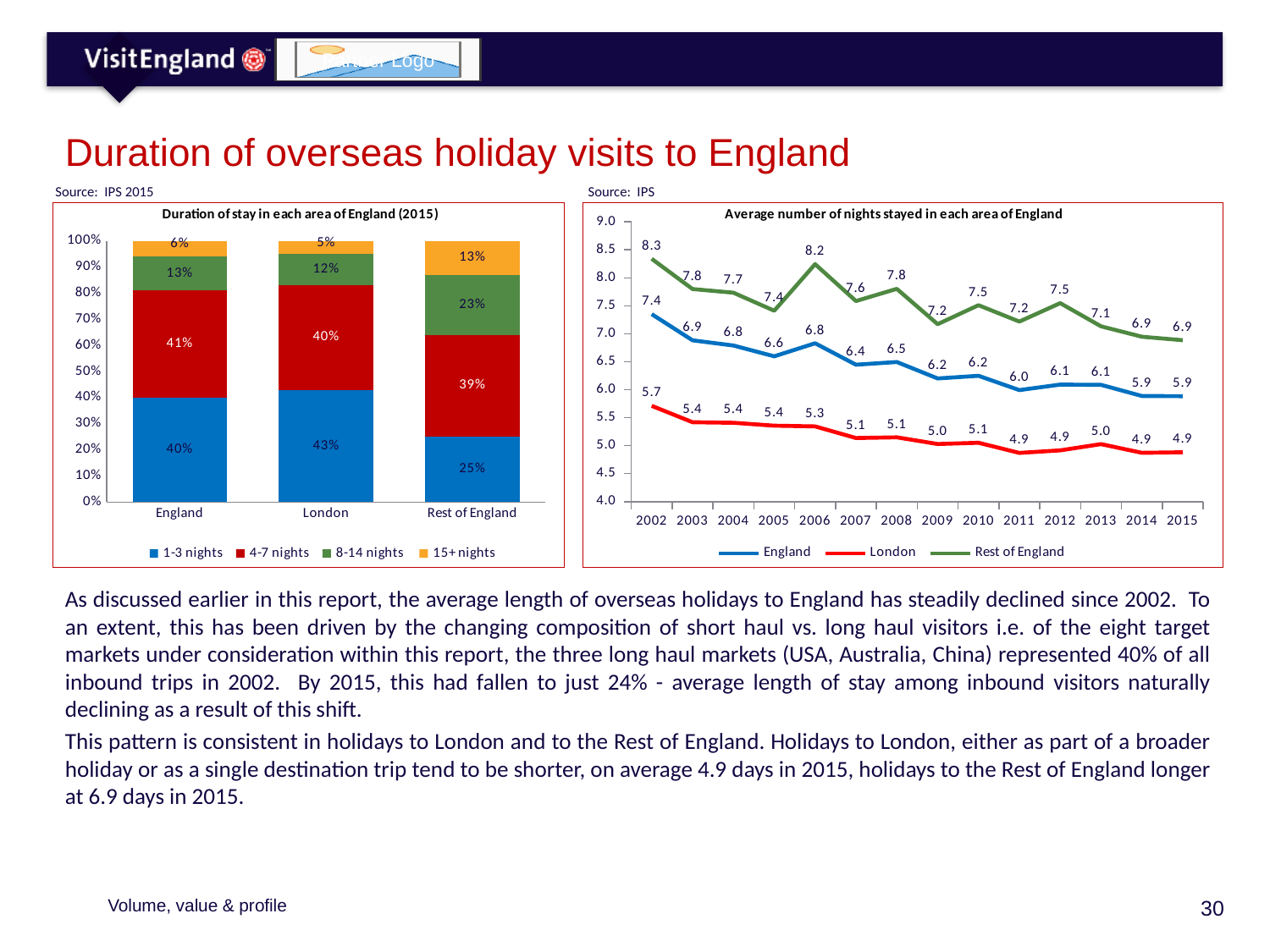
What type of chart is the 'Duration of stay in each area of England (2015)' chart? Stacked bar chart In the 'Duration of stay in each area of England (2015)' chart, what share of visits to the Rest of England are 15+ nights? 13% In the 'Duration of stay in each area of England (2015)' chart, which area has the largest share of 8-14 night stays? Rest of England In the 'Duration of stay in each area of England (2015)' chart, how many series does the legend list? 4 In the 'Average number of nights stayed in each area of England' chart, what was the average number of nights for the Rest of England in 2006? 8.2 In the 'Average number of nights stayed in each area of England' chart, what is the difference between the England value in 2002 and in 2015? 1.5 In the 'Average number of nights stayed in each area of England' chart, does the London series generally rise or fall from 2002 to 2015? Fall In the 'Duration of stay in each area of England (2015)' chart, what share of visits to London are 1-3 nights? 43% In the 'Average number of nights stayed in each area of England' chart, which year had the highest value for England? 2002 In the 'Duration of stay in each area of England (2015)' chart, what is the difference between the 1-3 nights share for London and for the Rest of England? 18 percentage points In the 'Average number of nights stayed in each area of England' chart, how many years are shown on the x axis? 14 In the 'Average number of nights stayed in each area of England' chart, what was the average number of nights for London in 2002? 5.7